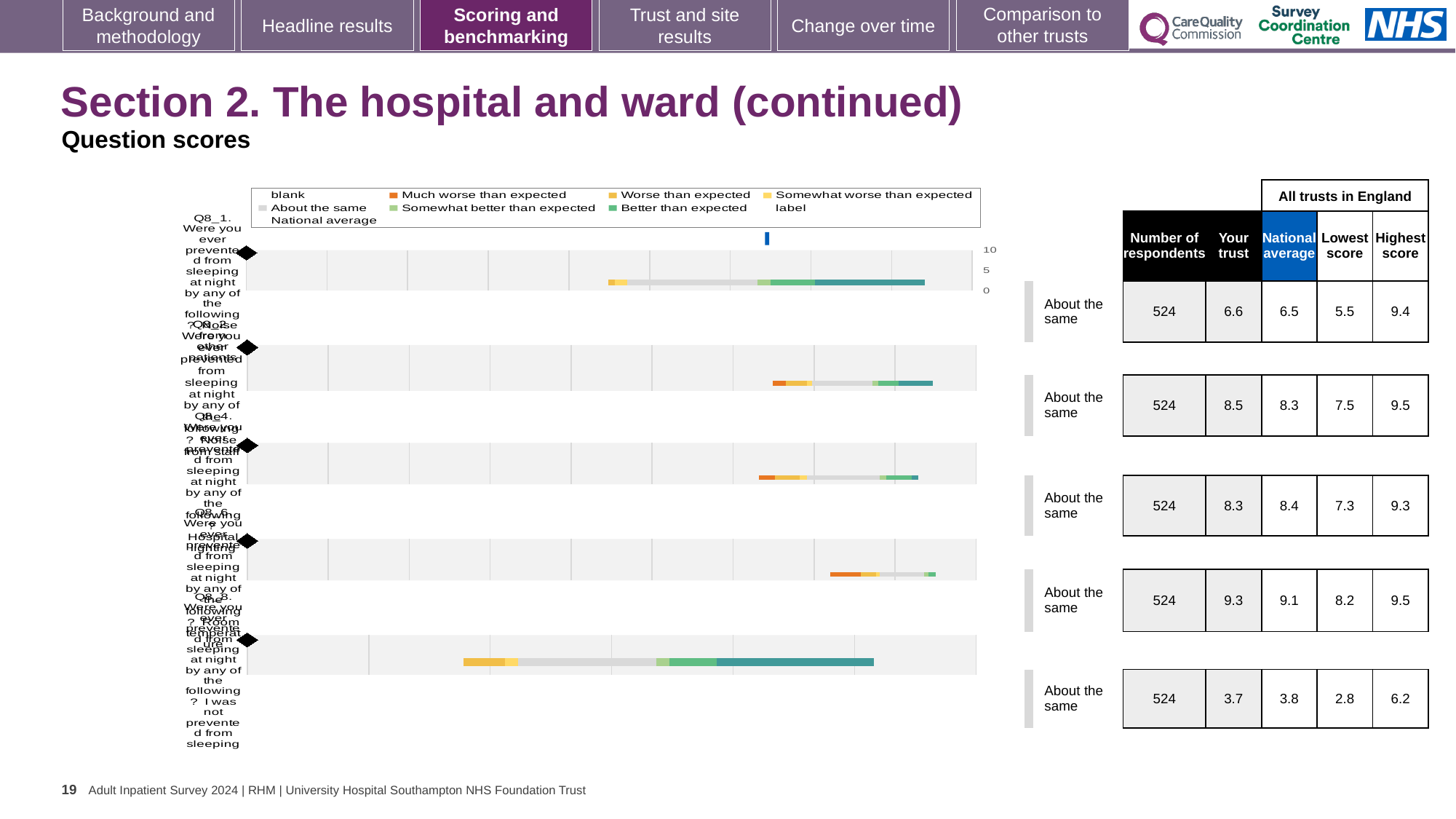
What is the highest score among all trusts in England for the fourth question row (Q8_6)? 9.5 What is the lowest score among all trusts in England for the fifth question row (Q8_8)? 2.8 For the third question row (Q8_4), which is larger: the 'Your trust' score or the national average? National average (8.4) Which question row has the highest 'Your trust' score? Q8_6 (fourth row), 9.3 Which question row has the lowest 'Your trust' score? Q8_8 (fifth row), 3.7 What is the 'Your trust' score for the first question row (Q8_1)? 6.6 What kind of chart is shown on the slide? bar chart How many question rows (bars) does the chart show? 5 What is the national average for the second question row (Q8_2)? 8.3 What is the number of respondents for the first question row (Q8_1)? 524 What is the difference between the highest score and the lowest score for the first question row (Q8_1)? 3.9 What benchmark category is shown next to every bar in the chart? About the same